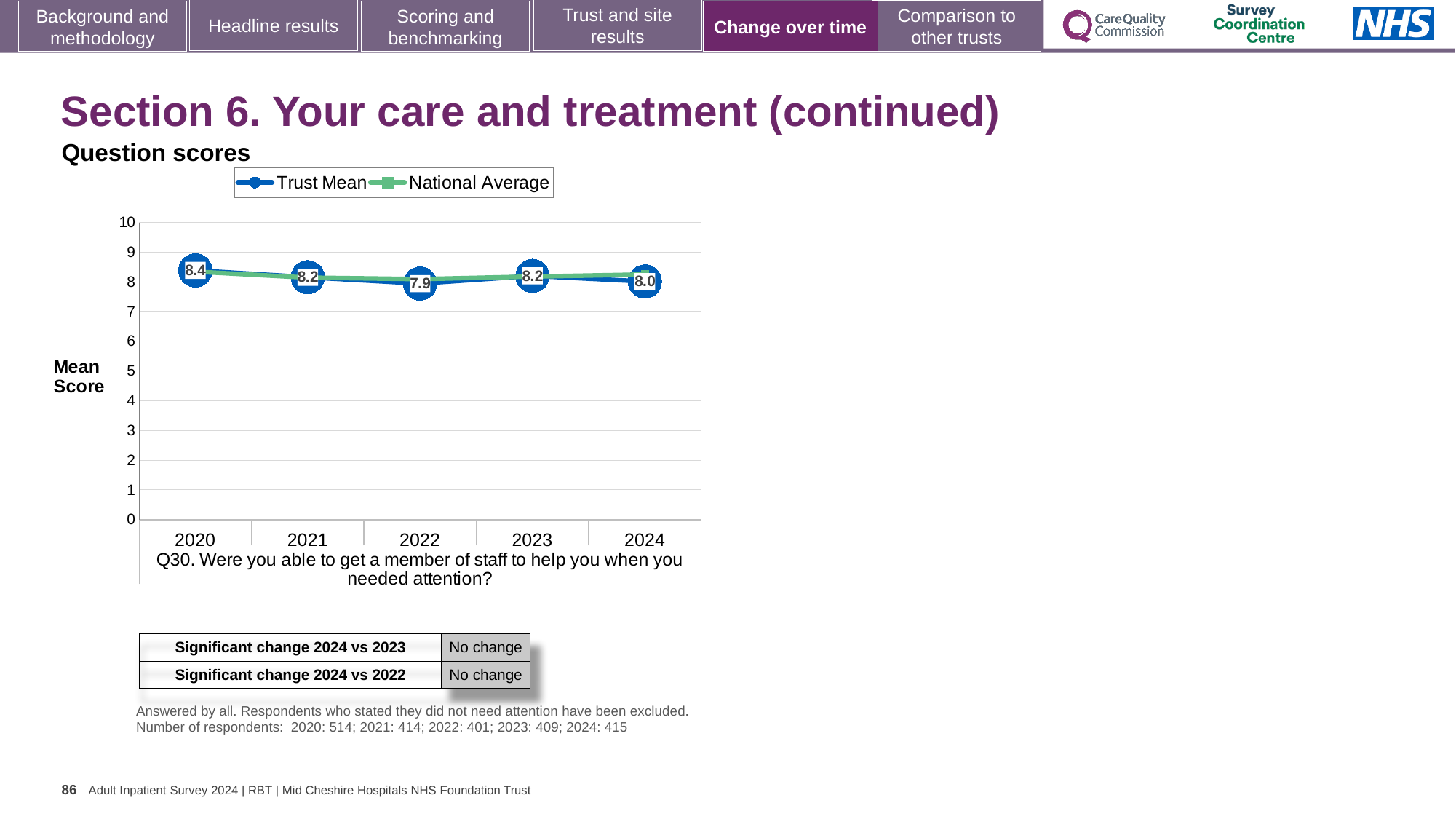
In which year was the Trust Mean score highest? 2020 What is the difference between the Trust Mean score in 2020 and in 2024? 0.4 Is the Trust Mean score for 2022 greater or less than 8? less What is the Trust Mean score for 2020? 8.4 Does the Trust Mean score rise or fall from 2020 to 2022? fall What is the Trust Mean score for 2022? 7.9 What is the Trust Mean score for 2024? 8.0 In which year was the Trust Mean score lowest? 2022 How many series does the legend list? 2 What kind of chart is shown? line chart Which year has the larger Trust Mean score, 2021 or 2022? 2021 How many years are plotted on the x axis? 5